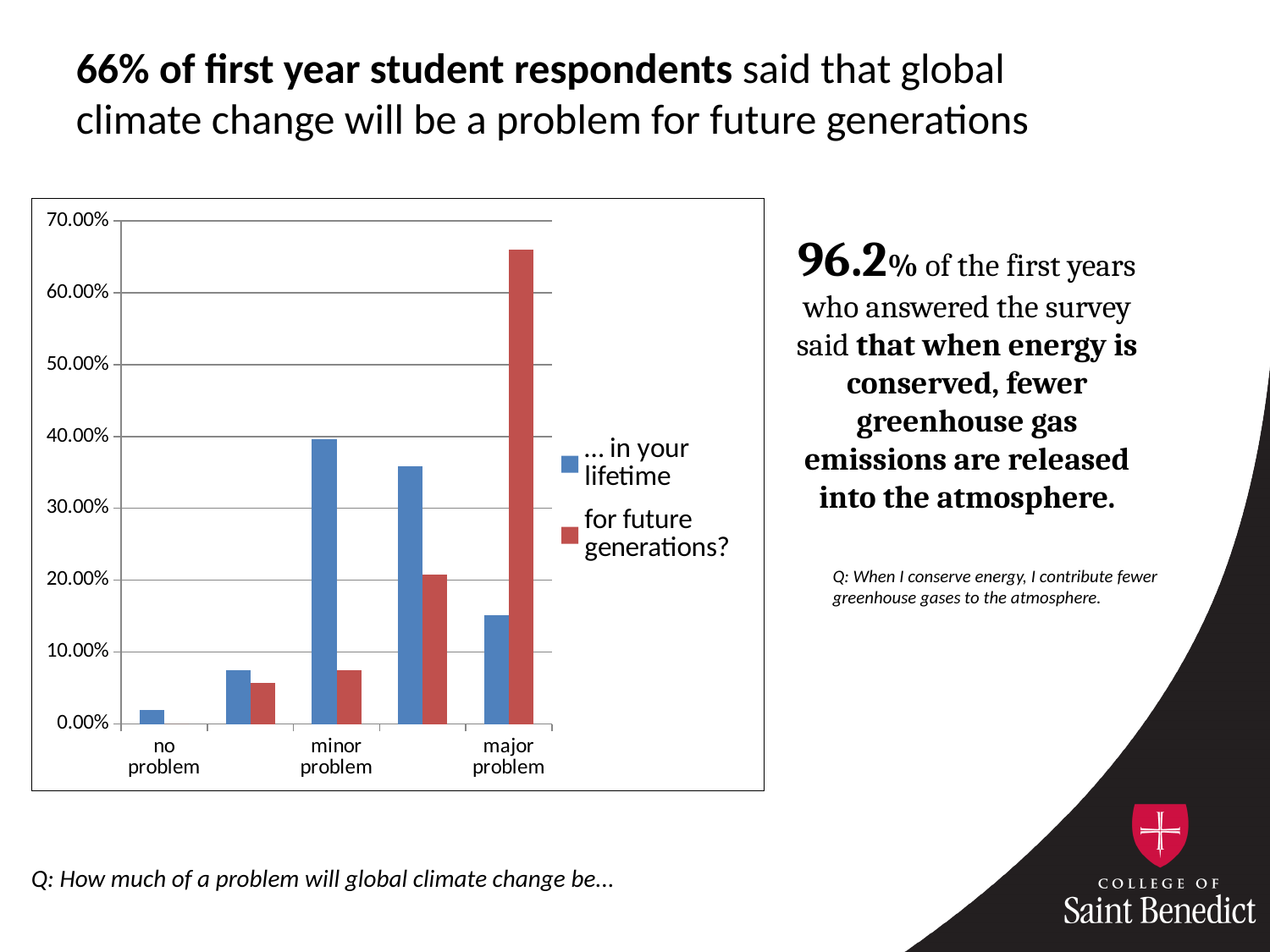
What kind of chart is shown on the slide? bar chart Which labeled category has the highest value for the "for future generations?" series? major problem How many series does the chart's legend list? 2 For the "major problem" category, which series has the larger value: "... in your lifetime" or "for future generations?"? for future generations? Is the "for future generations?" value for "major problem" greater or less than 60.00%? greater For the "... in your lifetime" series, which is larger: the value for "no problem" or the value for "major problem"? major problem Is the "for future generations?" value for "minor problem" greater or less than 10.00%? less For the "minor problem" category, which series has the larger value: "... in your lifetime" or "for future generations?"? ... in your lifetime Is the "... in your lifetime" value for "minor problem" greater or less than 30.00%? greater What colour are the bars for the "for future generations?" series? red What are the two series named in the chart's legend? ... in your lifetime; for future generations?